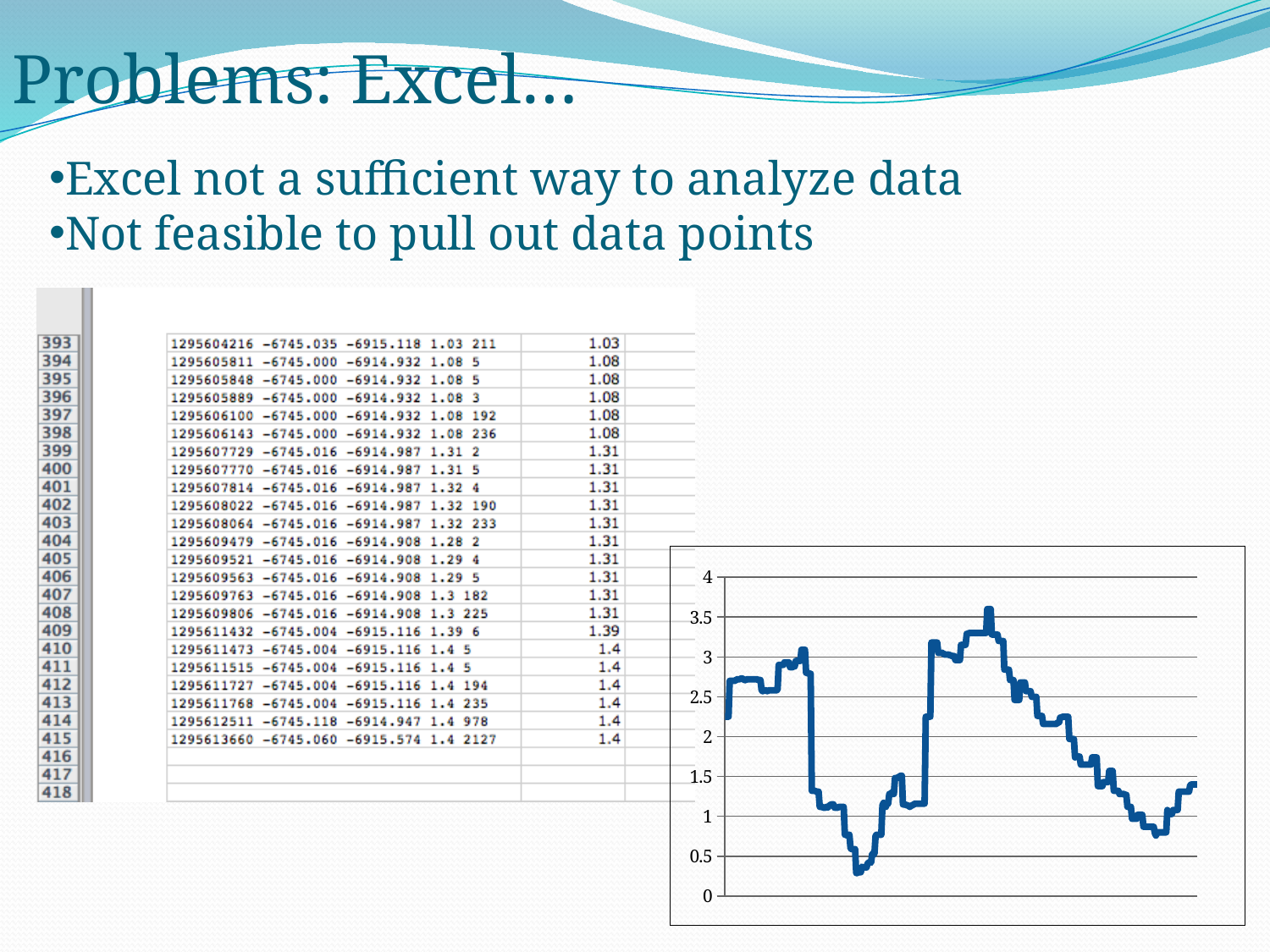
What is the lowest tick value shown on the chart's vertical axis? 0 Does the chart have a legend? No Is the value at the left end of the line greater or less than 2? greater What kind of chart is shown on the slide? line chart Is the value at the right end of the line greater or less than 2? less Does the line end higher or lower than where it starts? lower What is the highest tick value shown on the chart's vertical axis? 4 Is the lowest point reached by the line greater or less than 0.5? less How many lines are plotted on the chart? 1